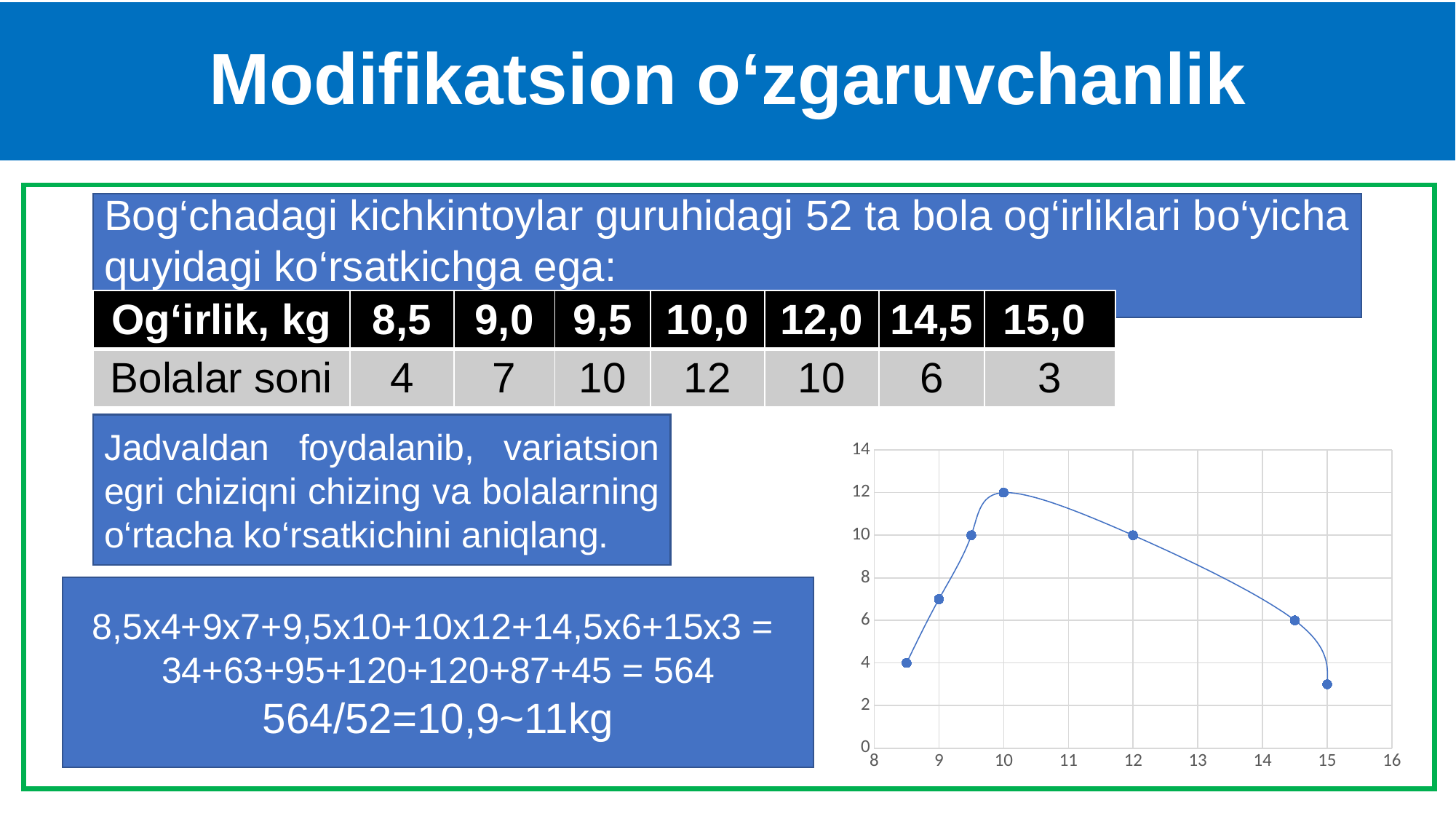
At which x value does the chart have its lowest point? 15 What is the y value of the point at x = 10 on the chart? 12 Is the y value of the point at x = 9 greater or less than 6? greater What is the difference between the y values at x = 10 and x = 8.5? 8 Do the y values rise or fall as x increases from 10 to 15? fall What kind of chart is shown on the slide? line chart What is the maximum value shown on the chart's x axis? 16 Which point has the larger y value: the one at x = 9.5 or the one at x = 14.5? x = 9.5 What is the y value of the point at x = 12 on the chart? 10 How many data points are plotted on the chart? 7 At which x value does the chart reach its highest point? 10 Is the y value of the point at x = 14.5 greater or less than 8? less